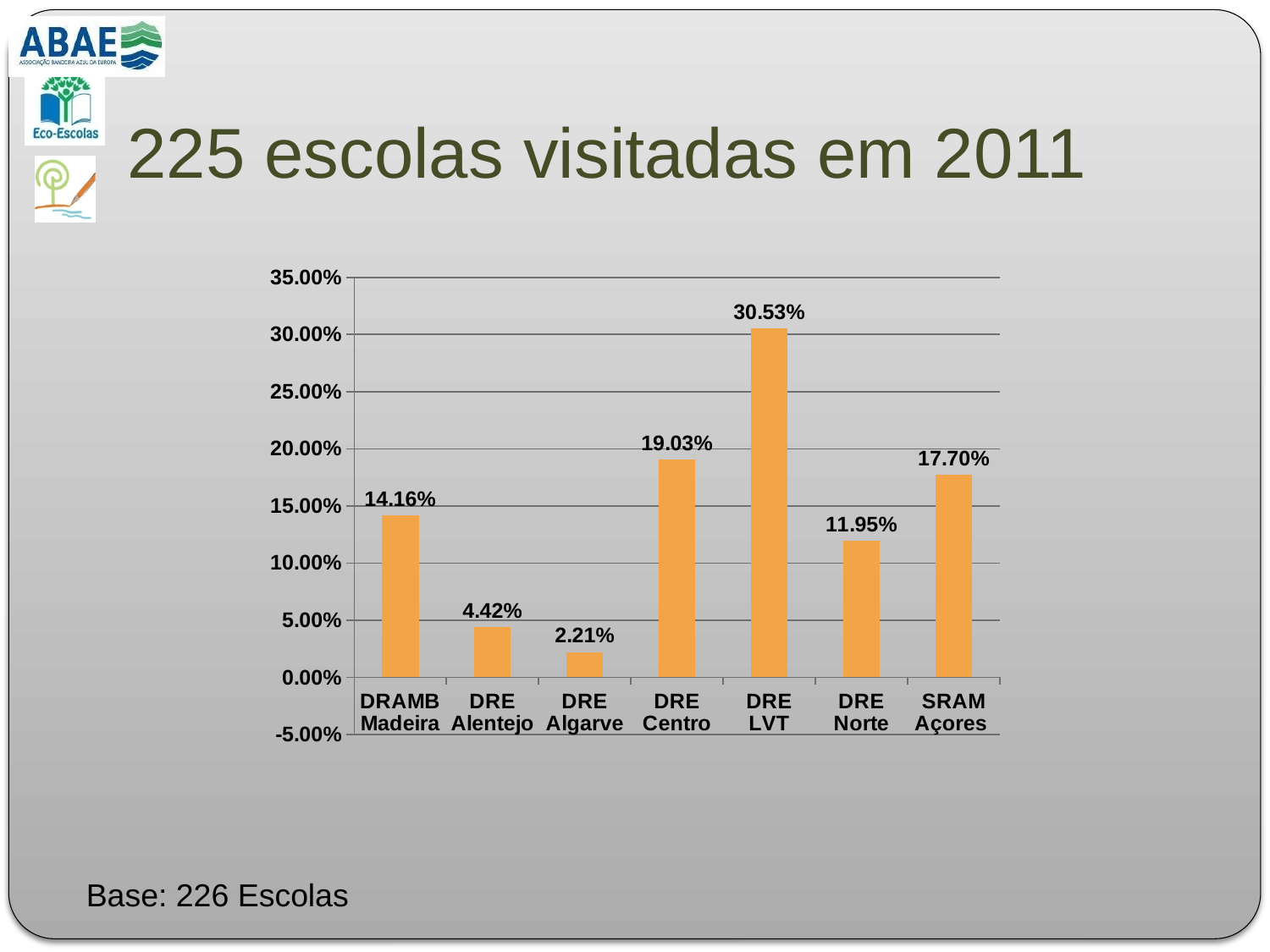
What is the value for DRE LVT? 30.53% What is the difference between the values for DRE Alentejo and DRE Algarve? 2.21% What is the value for SRAM Açores? 17.70% Which category has the highest value? DRE LVT Is the value for DRE Centro greater or less than 20.00%? less What is the value for DRAMB Madeira? 14.16% Which category has the lowest value? DRE Algarve What kind of chart is shown on the slide? bar chart Which is larger, the value for DRE Norte or the value for SRAM Açores? SRAM Açores What is the value for DRE Algarve? 2.21% How many categories are shown on the x axis? 7 What is the difference between the values for DRE LVT and DRE Centro? 11.50%